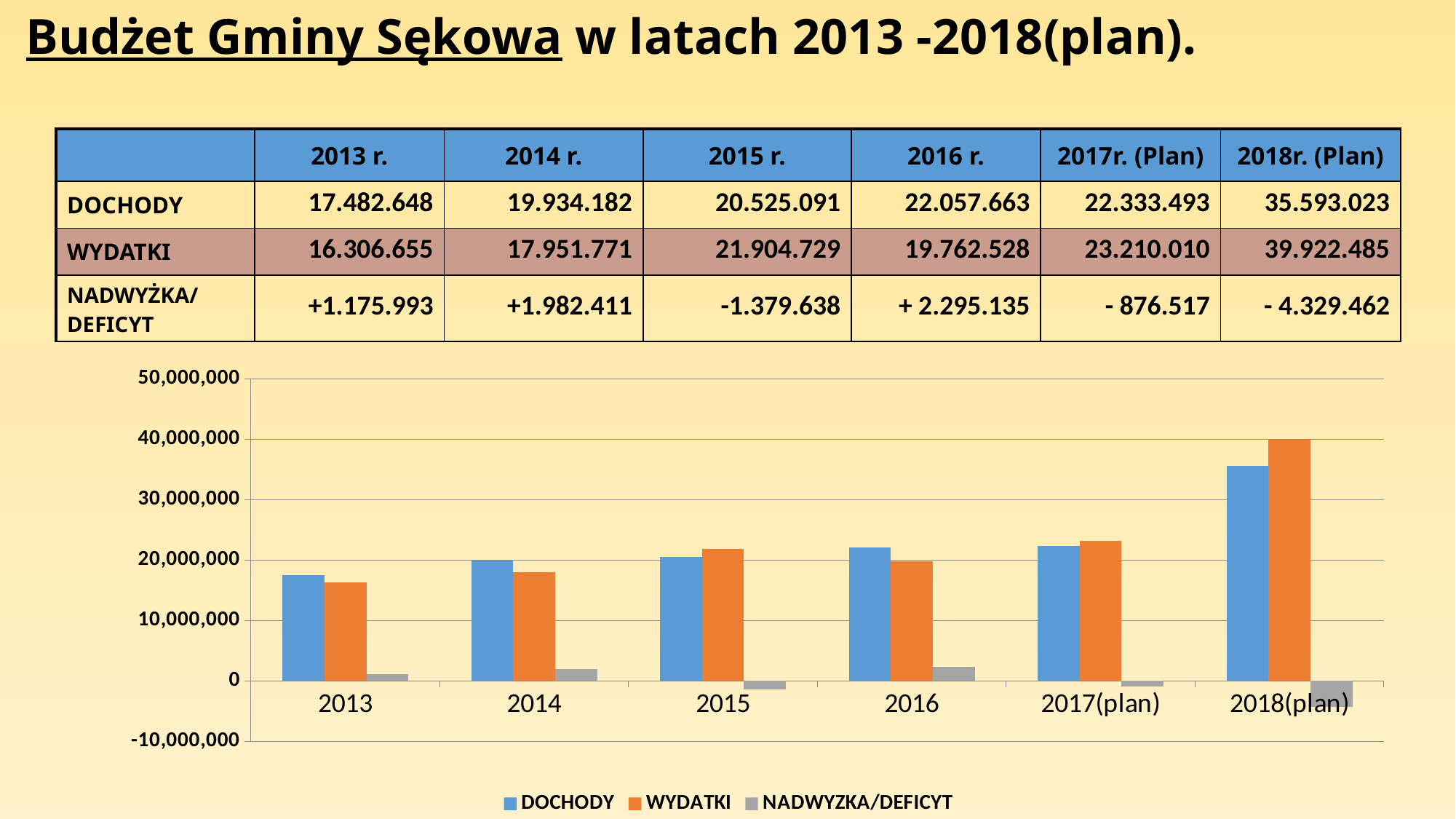
For 2015, which is larger, DOCHODY or WYDATKI? WYDATKI Do the DOCHODY bars rise or fall from 2013 to 2018(plan)? rise In which year is the DOCHODY bar the lowest? 2013 How many series does the chart legend list? 3 Is the DOCHODY value for 2018(plan) greater or less than 30,000,000? greater What is the DOCHODY value for 2016 r. shown in the table? 22.057.663 What is the NADWYŻKA/DEFICYT value for 2014 r. shown in the table? +1.982.411 What colour are the WYDATKI bars in the chart? orange What kind of chart is shown on the slide? bar chart How many years (categories) are shown on the x axis of the chart? 6 In which year is the WYDATKI bar the highest? 2018(plan) What is the WYDATKI value for 2018r. (Plan) shown in the table? 39.922.485